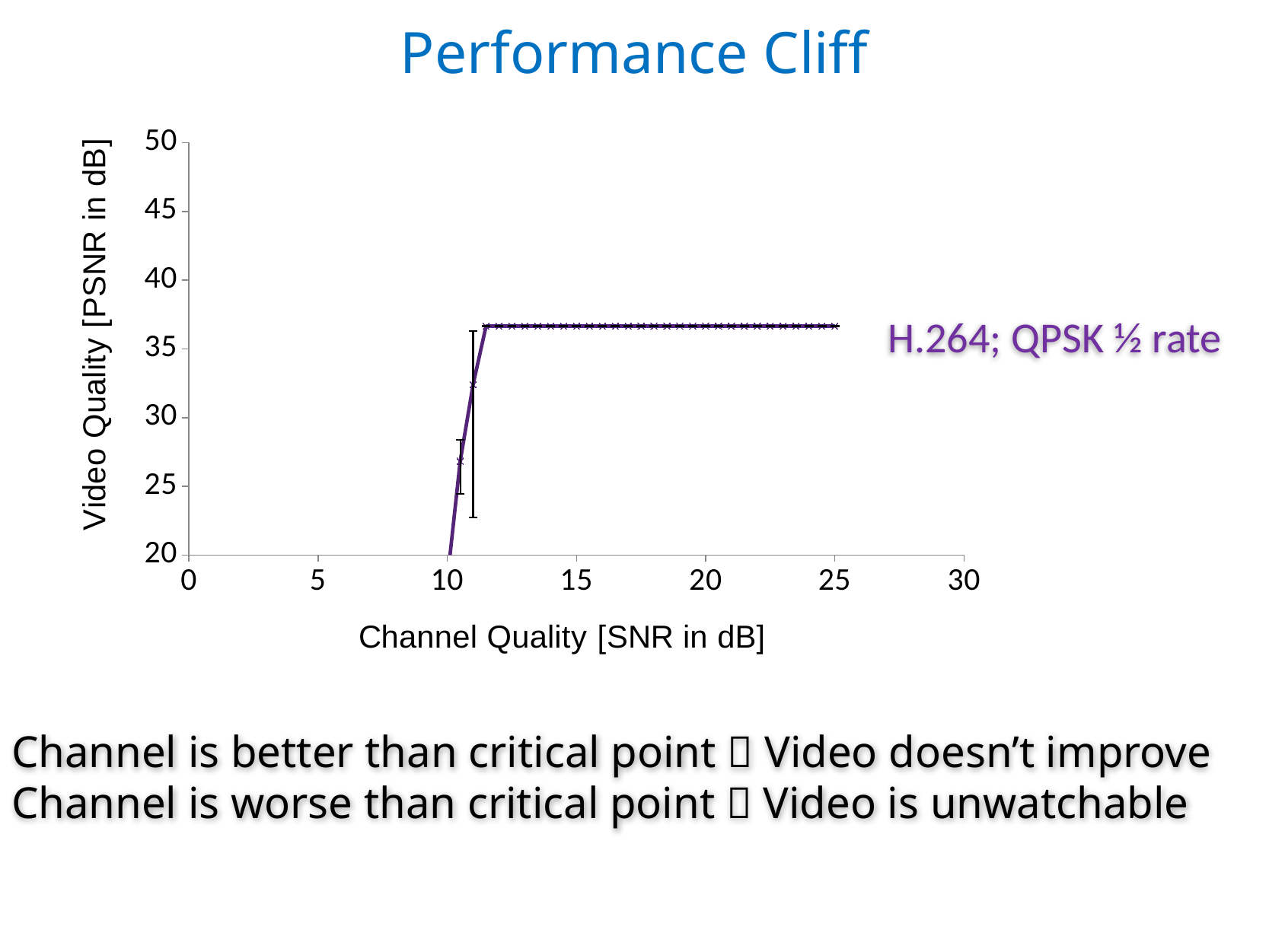
What is the label of the y axis? Video Quality [PSNR in dB] How many data series are plotted on the chart? 1 Is the video quality at a channel SNR of 15 dB larger or smaller than at a channel SNR of 10.5 dB? larger What is the title of the slide's chart? Performance Cliff Is the video quality at a channel SNR of 20 dB greater or less than 40? less Does the video quality rise, fall, or stay flat as channel SNR increases from 15 dB to 25 dB? stay flat Does the video quality rise or fall as channel SNR increases from 10 dB to 12 dB? rise Is the video quality at a channel SNR of about 10.5 dB greater or less than 30? less Is the video quality at a channel SNR of 25 dB greater or less than 35? greater What kind of chart is shown on the slide? line chart